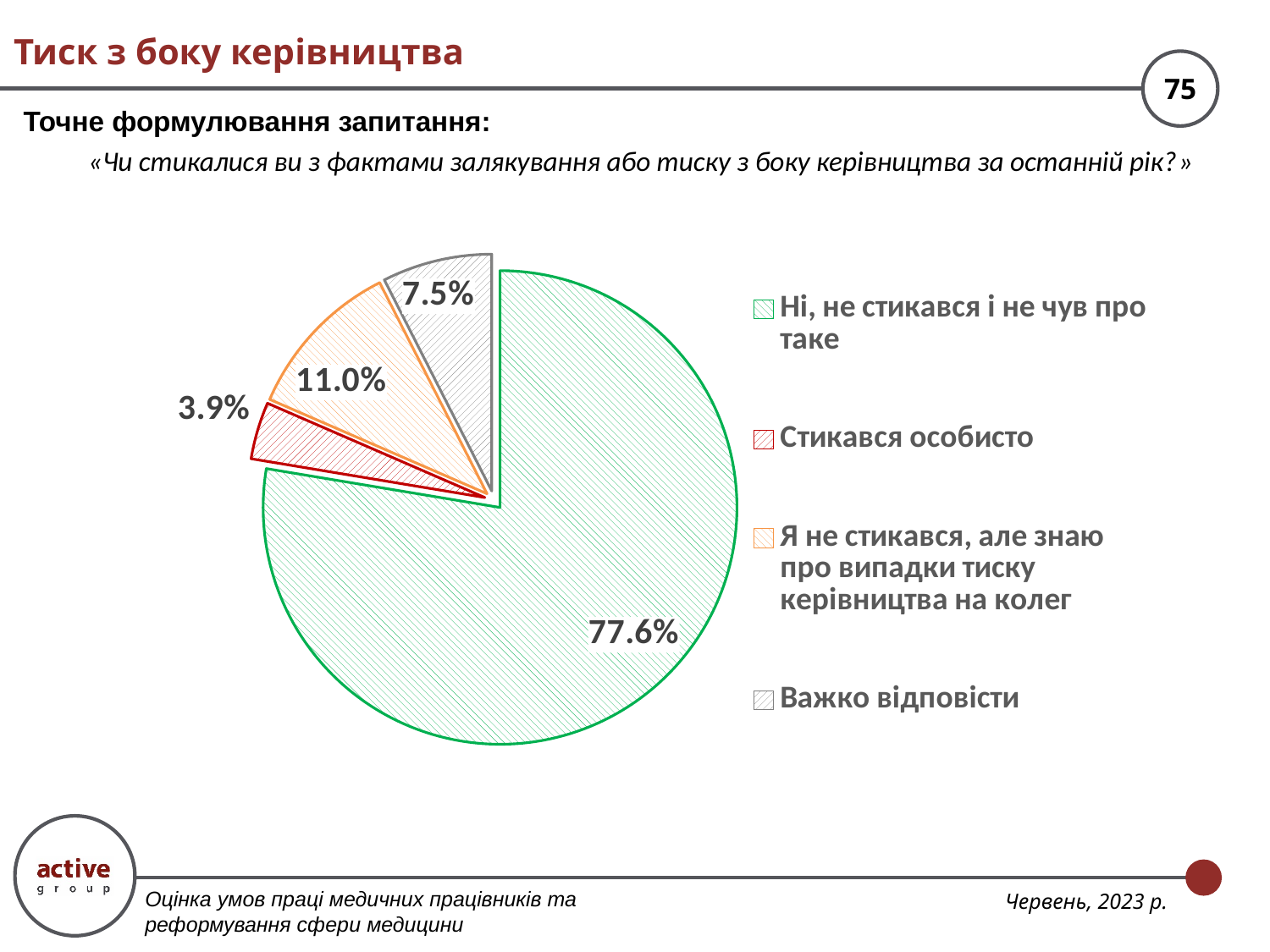
What colour is the outline of the slice labelled 3.9%? red What kind of chart is shown on the slide? pie chart Which is larger: the share for "Важко відповісти" or the share for "Стикався особисто"? Важко відповісти Which answer option has the smallest share of the pie? Стикався особисто Which answer option has the largest share of the pie? Ні, не стикався і не чув про таке What share of respondents answered "Я не стикався, але знаю про випадки тиску керівництва на колег"? 11.0% What share of respondents answered "Ні, не стикався і не чув про таке"? 77.6% What is the difference in percentage points between "Я не стикався, але знаю про випадки тиску керівництва на колег" and "Стикався особисто"? 7.1 How many slices does the pie chart have? 4 What is the difference in percentage points between "Ні, не стикався і не чув про таке" and "Важко відповісти"? 70.1 What share of respondents answered "Важко відповісти"? 7.5% What share of respondents answered "Стикався особисто"? 3.9%